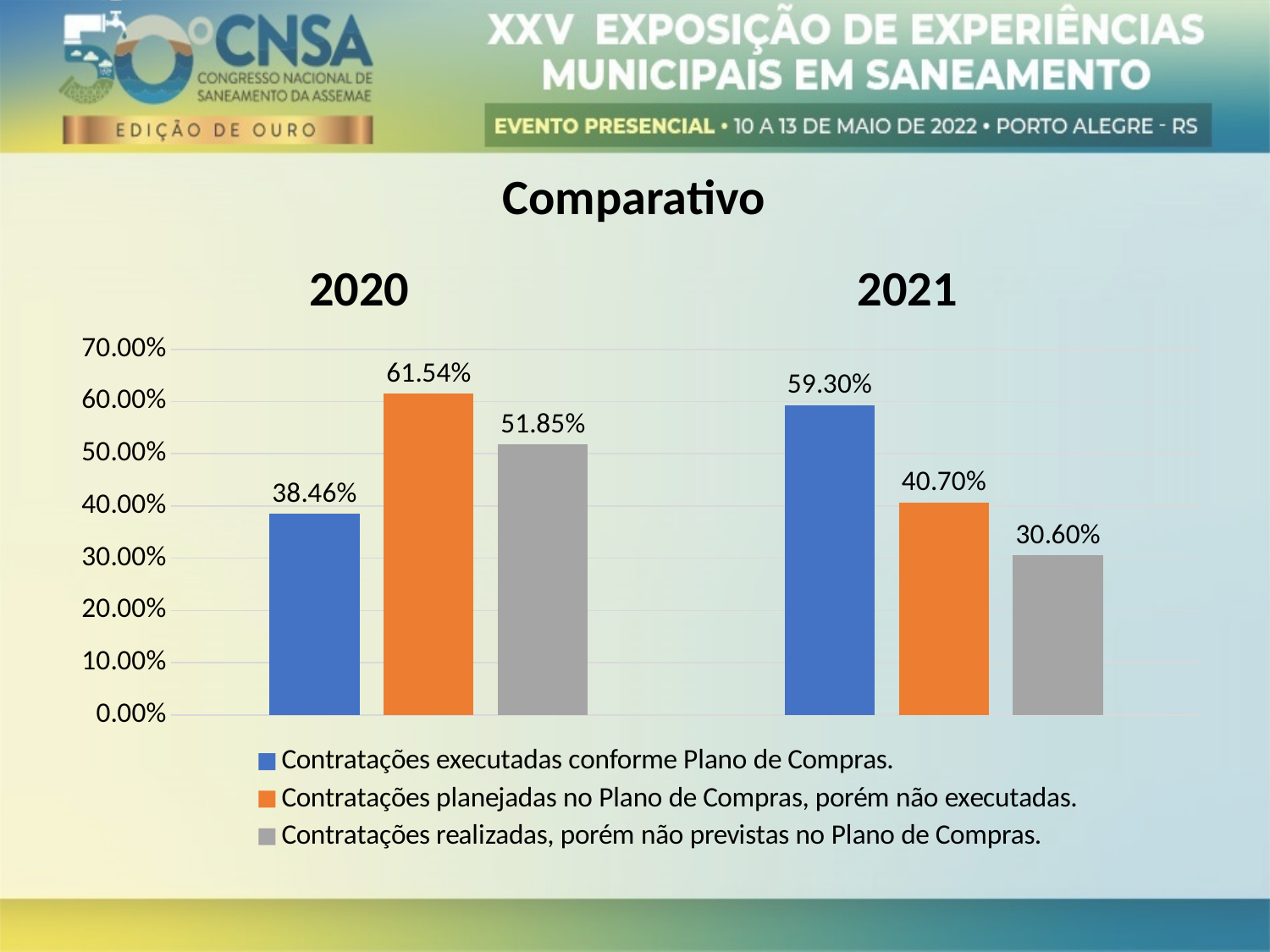
What is the difference between the 2020 and 2021 values for "Contratações executadas conforme Plano de Compras."? 20.84% What is the value for "Contratações planejadas no Plano de Compras, porém não executadas." in 2021? 40.70% Which series has the lowest value in 2020? Contratações executadas conforme Plano de Compras. What is the title of the chart? Comparativo Which is larger: the 2020 value for "Contratações planejadas no Plano de Compras, porém não executadas." or the 2021 value for the same series? 2020 What is the value for "Contratações realizadas, porém não previstas no Plano de Compras." in 2020? 51.85% How many series does the legend list? 3 What is the value for "Contratações executadas conforme Plano de Compras." in 2020? 38.46% How many year categories are shown on the x axis? 2 What kind of chart is shown on the slide? bar chart Is the 2021 value for "Contratações realizadas, porém não previstas no Plano de Compras." greater or less than 40.00%? less Which series has the highest value in 2021? Contratações executadas conforme Plano de Compras.